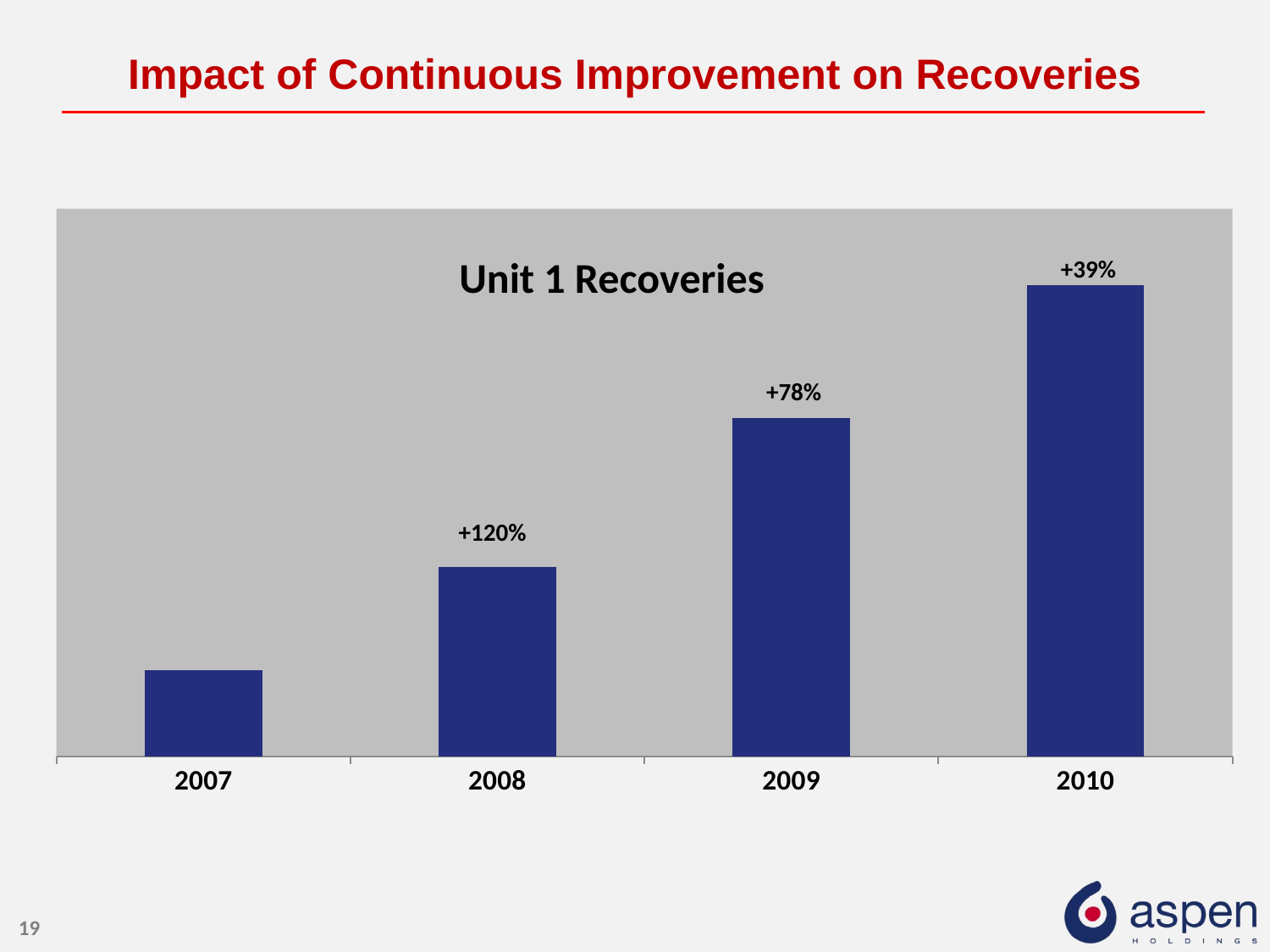
Which printed percentage label is larger, the one for 2008 or the one for 2010? 2008 (+120%) Do the bars in the Unit 1 Recoveries chart rise or fall from 2007 to 2010? Rise What label is printed above the 2009 bar in the Unit 1 Recoveries chart? +78% Which year has the tallest bar in the Unit 1 Recoveries chart? 2010 What label is printed above the 2008 bar in the Unit 1 Recoveries chart? +120% What label is printed above the 2010 bar in the Unit 1 Recoveries chart? +39% Which year's bar has no percentage label above it in the Unit 1 Recoveries chart? 2007 How many years are shown on the x axis of the Unit 1 Recoveries chart? 4 Which year has the shortest bar in the Unit 1 Recoveries chart? 2007 What kind of chart is used to show Unit 1 Recoveries? Bar chart What is the title of the chart on the slide? Unit 1 Recoveries Which bar is taller in the Unit 1 Recoveries chart, 2008 or 2009? 2009